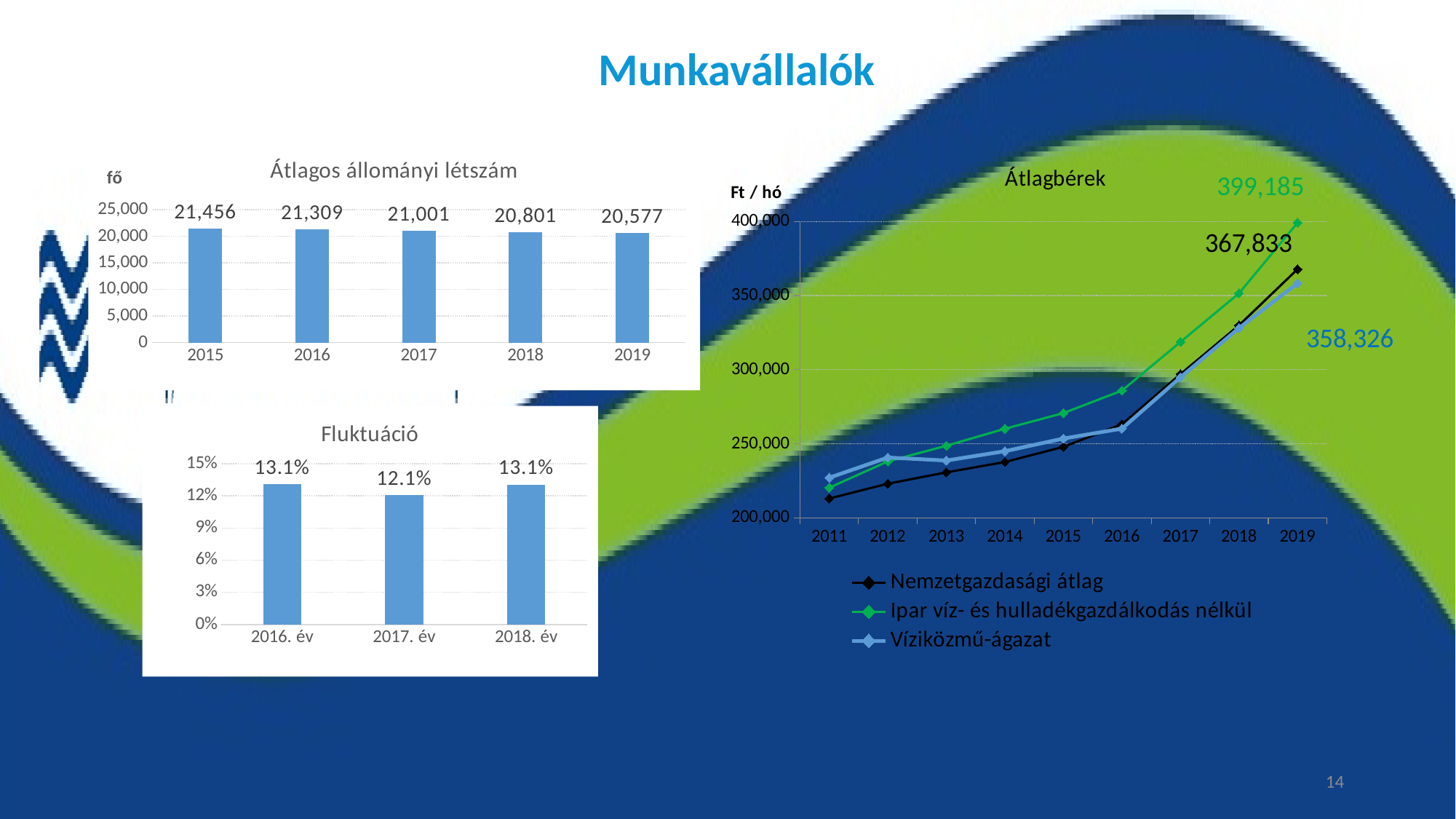
How many series does the legend of the 'Átlagbérek' chart list? 3 In the 'Átlagos állományi létszám' chart, what is the difference between the 2015 and 2019 values? 879 In the 'Átlagbérek' chart, what is the 2019 value for 'Ipar víz- és hulladékgazdálkodás nélkül'? 399,185 In the 'Fluktuáció' chart, which year has the lowest value? 2017. év In the 'Átlagos állományi létszám' chart, what is the value for 2017? 21,001 In the 'Átlagos állományi létszám' chart, which year has the highest value? 2015 In the 'Átlagos állományi létszám' chart, do the values rise or fall from 2015 to 2019? fall What kind of chart is the 'Fluktuáció' chart? bar chart In the 'Fluktuáció' chart, what is the value for 2017. év? 12.1% How many years are shown in the 'Átlagos állományi létszám' chart? 5 In the 'Átlagos állományi létszám' chart, which year has the lowest value? 2019 In the 'Átlagbérek' chart, is the 2011 value for 'Nemzetgazdasági átlag' greater or less than 250,000? less